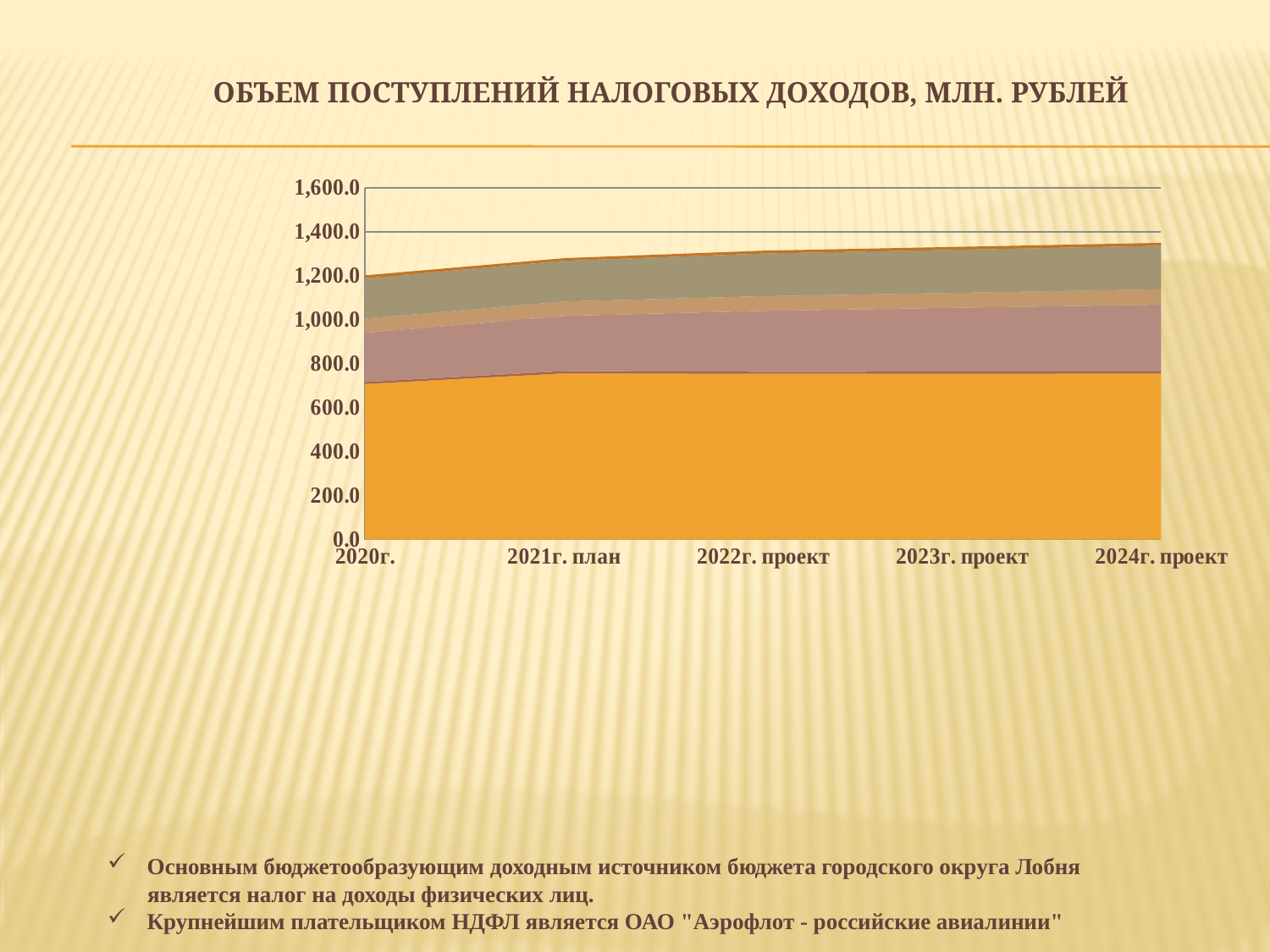
What is the title of the chart? ОБЪЕМ ПОСТУПЛЕНИЙ НАЛОГОВЫХ ДОХОДОВ, МЛН. РУБЛЕЙ Is the total height of the stacked areas for 2020г. greater or less than 1,000.0? greater How many categories are shown along the x axis? 5 Which category is the first on the x axis? 2020г. What is the highest value shown on the y axis? 1,600.0 Is the value of the bottom (orange) area for 2020г. greater or less than 800.0? less What kind of chart is shown on the slide? area chart Is the total height of the stacked areas for 2024г. проект greater or less than 1,400.0? less Does the total height of the stacked areas rise or fall from 2020г. to 2024г. проект? rise Which has the larger total height of the stacked areas, 2020г. or 2022г. проект? 2022г. проект Which category has the lowest total height of the stacked areas? 2020г.